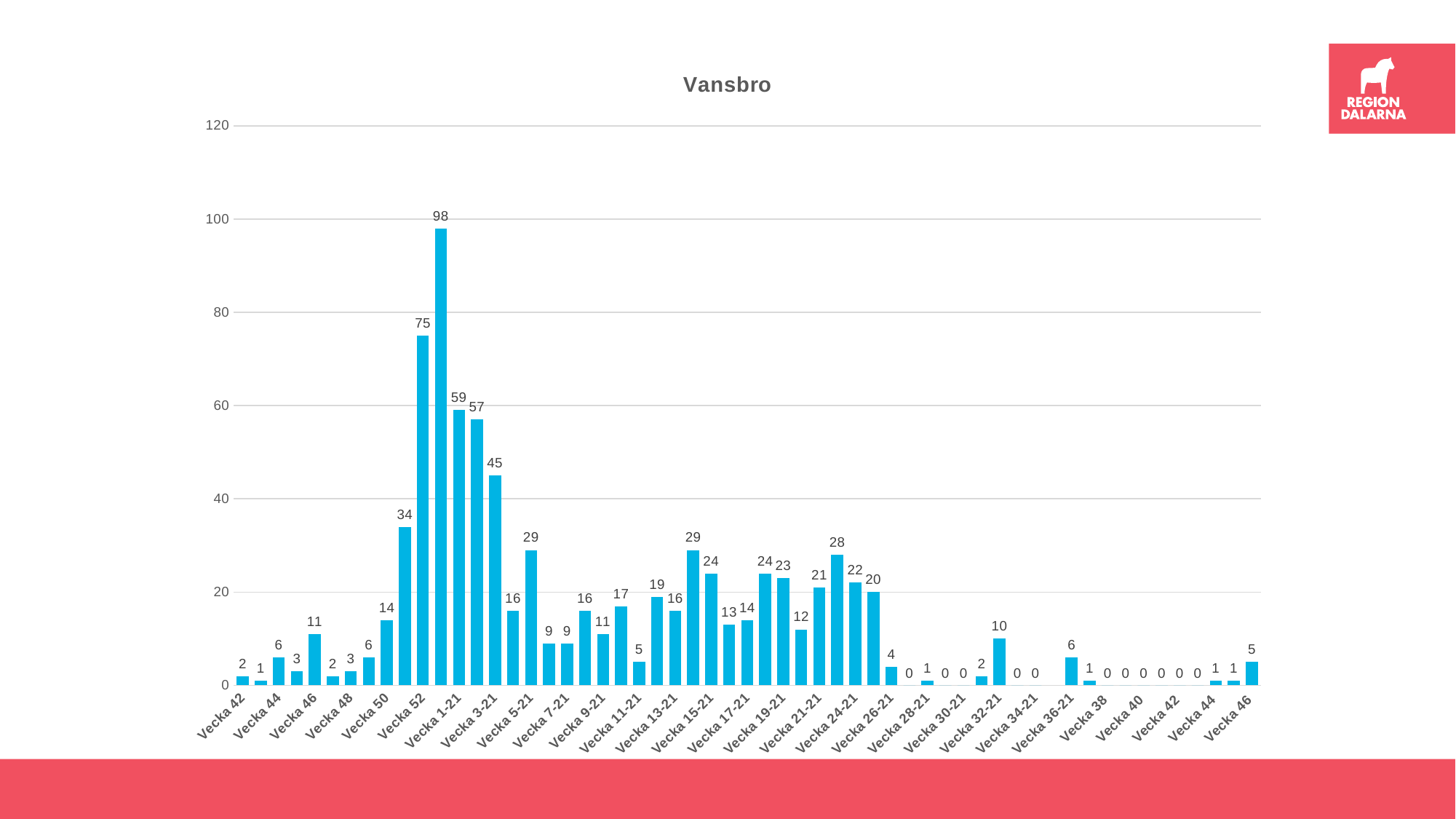
What is the highest value shown in the chart? 98 What kind of chart is shown on the slide? bar chart What is the value for Vecka 3-21? 45 Which has the larger value, Vecka 3-21 or Vecka 5-21? Vecka 3-21 What is the value for Vecka 52? 75 What is the difference between the values for Vecka 52 and Vecka 1-21? 16 What is the title of the chart? Vansbro What colour are the bars in the chart? blue Is the value for Vecka 52 greater or less than 60? greater What is the value for Vecka 1-21? 59 What is the value for Vecka 32-21? 10